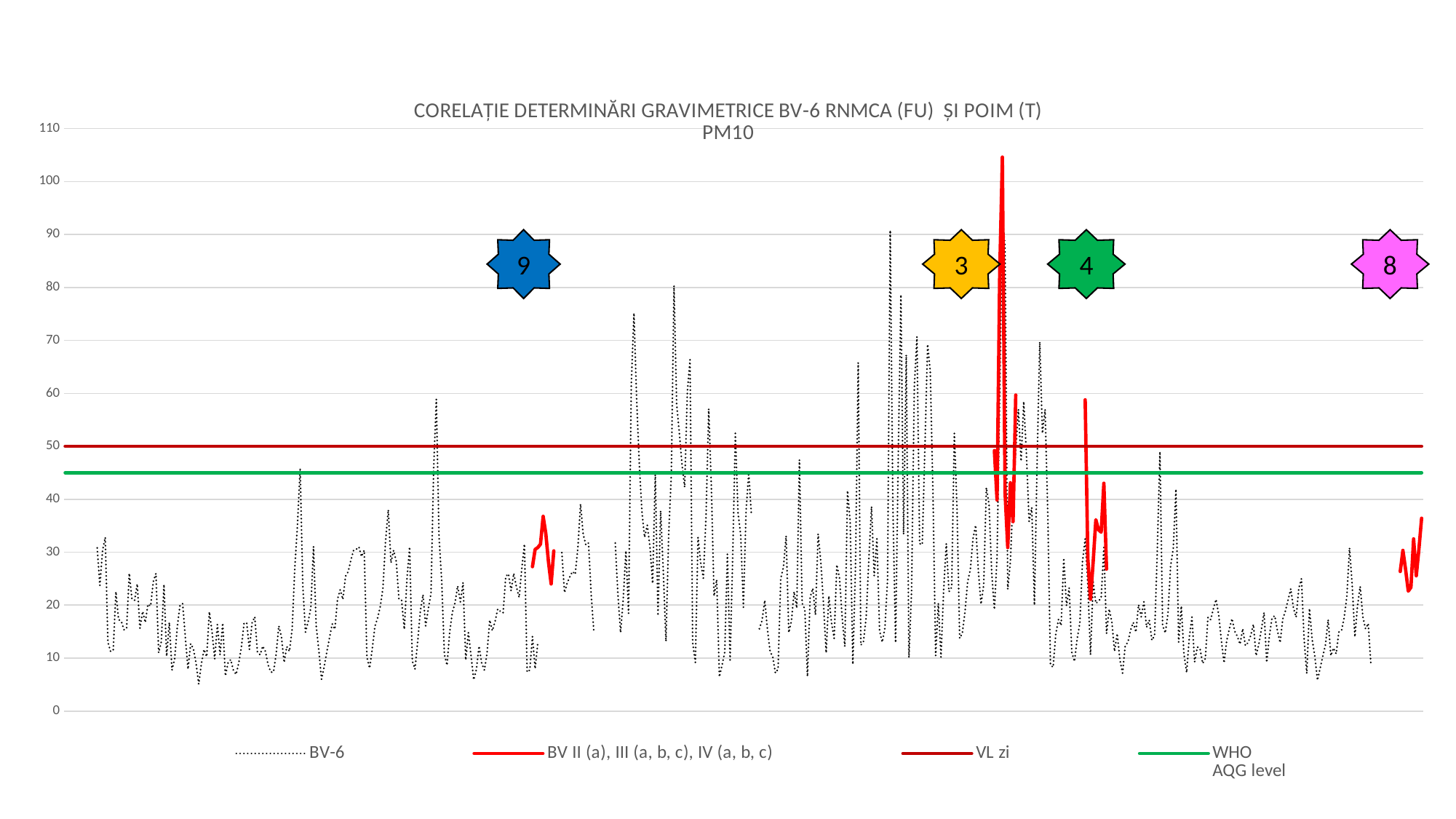
Is the highest peak of the red BV II (a), III (a, b, c), IV (a, b, c) series greater or less than 100? greater At what value does the horizontal VL zi line sit on the y axis? 50 Is the highest peak of the BV-6 series greater or less than 80? greater How many series does the legend list? 4 What is the maximum value shown on the y axis? 110 Which horizontal reference line is higher, VL zi or WHO AQG level? VL zi What kind of chart is shown on the slide? line chart Which series is drawn as a dotted black line? BV-6 Is the WHO AQG level line greater or less than 50? less What is the title of the chart? CORELAȚIE DETERMINĂRI GRAVIMETRICE BV-6 RNMCA (FU) ȘI POIM (T) PM10